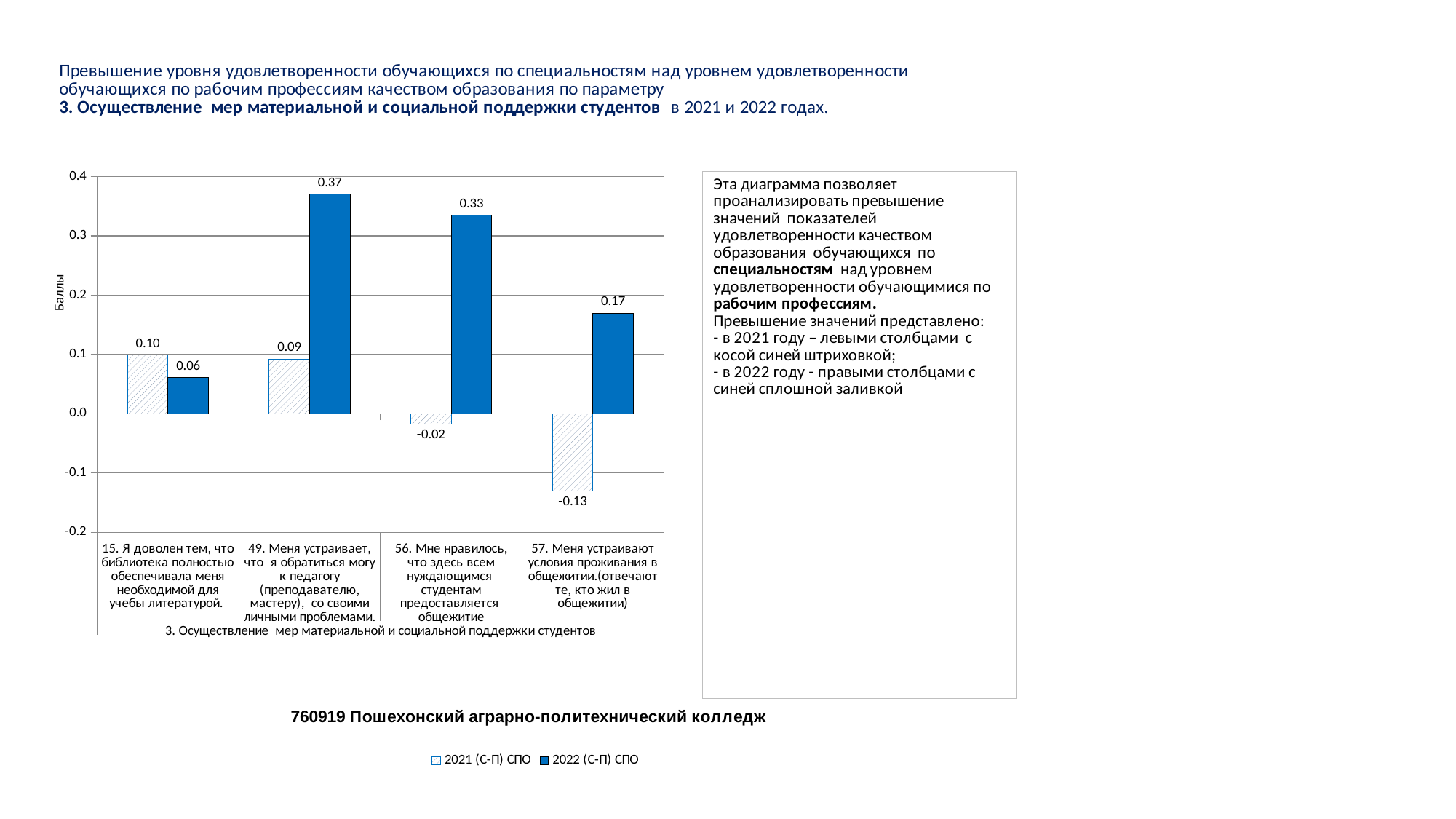
What is the difference between the 2022 and 2021 values for category 49? 0.28 How many series does the chart legend list? 2 What is the value for the 2022 (С-П) СПО series for category 49 (Меня устраивает, что я обратиться могу к педагогу)? 0.37 What is the value for the 2022 (С-П) СПО series for category 56 (Мне нравилось, что здесь всем нуждающимся студентам предоставляется общежитие)? 0.33 For category 15, which series has the larger value, 2021 (С-П) СПО or 2022 (С-П) СПО? 2021 (С-П) СПО What is the value for the 2021 (С-П) СПО series for category 15 (Я доволен тем, что библиотека полностью обеспечивала меня необходимой для учебы литературой)? 0.10 Which category has the lowest value in the 2021 (С-П) СПО series? 57. Меня устраивают условия проживания в общежитии.(отвечают те, кто жил в общежитии) What is the value for the 2021 (С-П) СПО series for category 57 (Меня устраивают условия проживания в общежитии)? -0.13 Which category has the highest value in the 2022 (С-П) СПО series? 49. Меня устраивает, что я обратиться могу к педагогу (преподавателю, мастеру), со своими личными проблемами. What is the label of the vertical axis of the chart? Баллы What type of chart is shown on the slide? Bar chart How many categories are shown on the x axis of the chart? 4